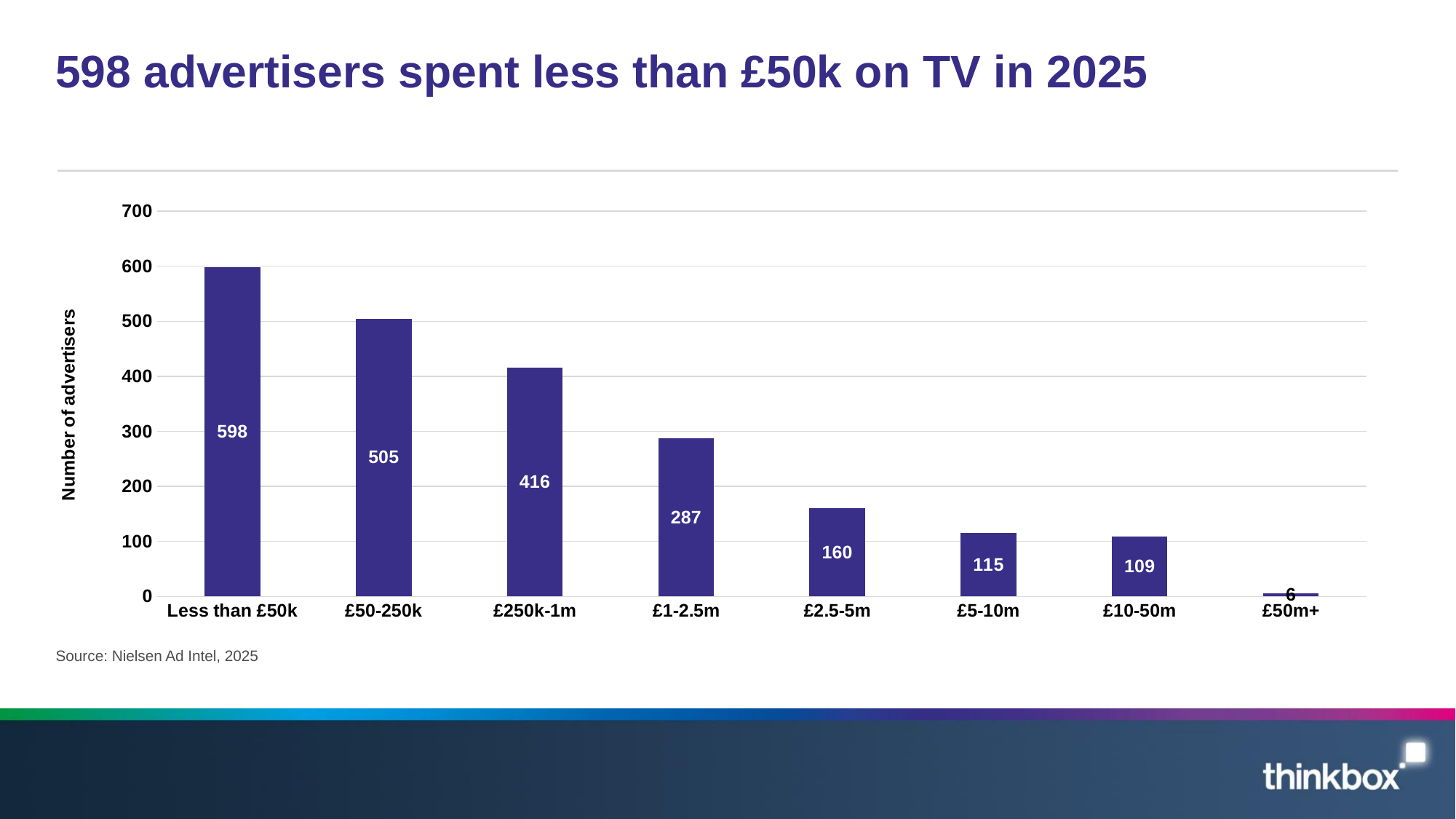
Which has more advertisers: the £5-10m band or the £10-50m band? £5-10m What kind of chart is shown on the slide? Bar chart How many advertisers spent £50-250k on TV in 2025? 505 What is the difference in the number of advertisers between the Less than £50k band and the £50-250k band? 93 Which spend band has the highest number of advertisers? Less than £50k Which spend band has the lowest number of advertisers? £50m+ What is the difference in the number of advertisers between the £250k-1m band and the £1-2.5m band? 129 How many spend bands are shown on the x axis? 8 What is the number of advertisers in the £1-2.5m spend band? 287 Do the values rise or fall as the spend bands increase along the x axis? Fall Is the number of advertisers in the £2.5-5m band greater or less than 200? less How many advertisers are in the £50m+ band? 6